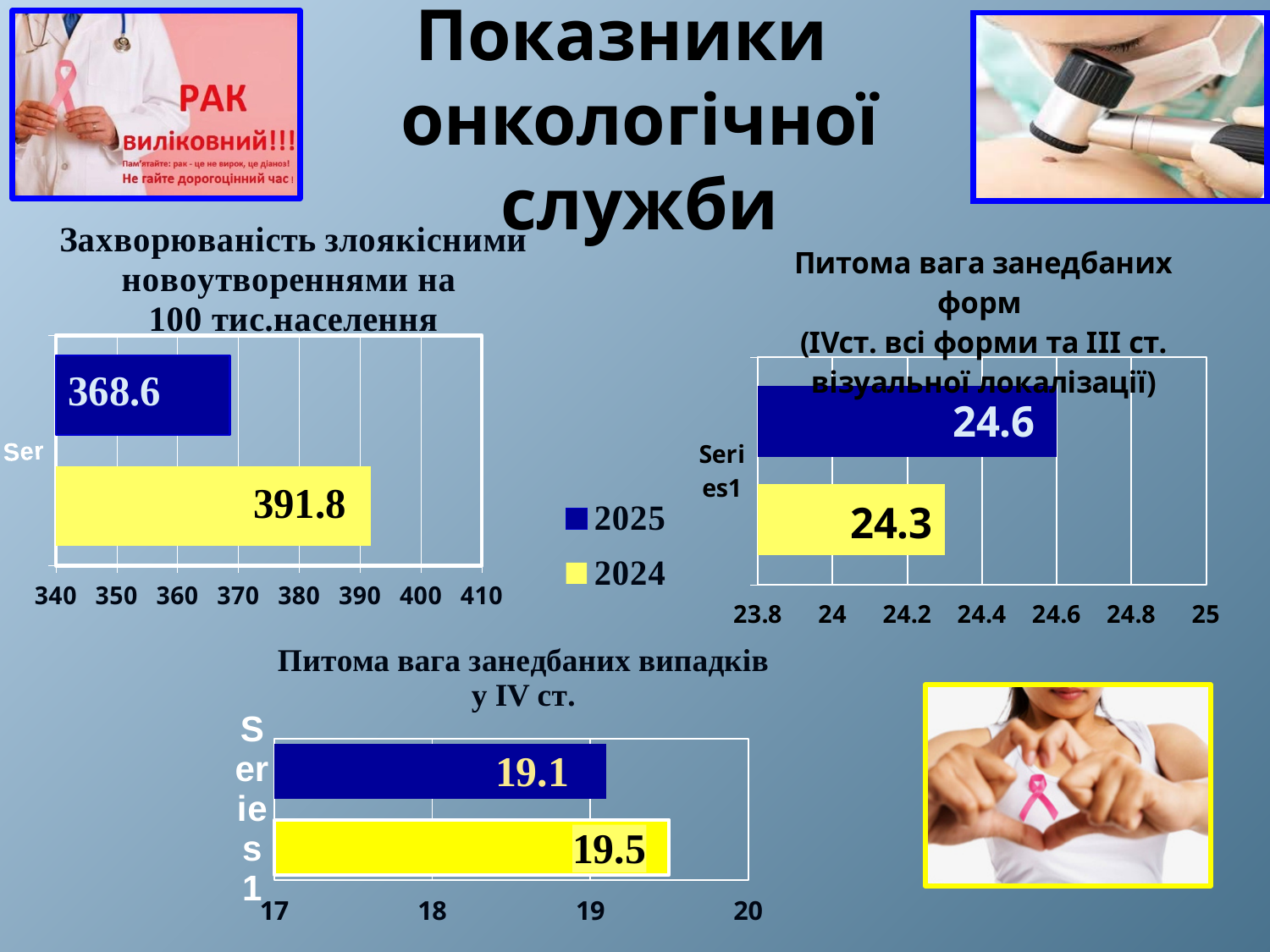
On the chart 'Захворюваність злоякісними новоутвореннями на 100 тис.населення', what is the difference between the 2024 and 2025 values? 23.2 On the chart 'Захворюваність злоякісними новоутвореннями на 100 тис.населення', which year has the larger value, 2024 or 2025? 2024 On the chart 'Питома вага занедбаних випадків у IV ст.', what is the difference between the 2024 and 2025 values? 0.4 On the chart 'Питома вага занедбаних форм', what is the value of the yellow bar (2024)? 24.3 On the chart 'Питома вага занедбаних форм', what is the value of the dark blue bar (2025)? 24.6 On the chart 'Питома вага занедбаних випадків у IV ст.', what is the value of the yellow bar (2024)? 19.5 What type of chart is 'Питома вага занедбаних випадків у IV ст.'? Bar chart On the chart 'Захворюваність злоякісними новоутвореннями на 100 тис.населення', what is the value of the dark blue bar (2025)? 368.6 How many series does the legend on the slide list? 2 On the chart 'Питома вага занедбаних випадків у IV ст.', what is the value of the dark blue bar (2025)? 19.1 On the chart 'Захворюваність злоякісними новоутвореннями на 100 тис.населення', what is the value of the yellow bar (2024)? 391.8 On the chart 'Питома вага занедбаних форм', which year has the higher value? 2025